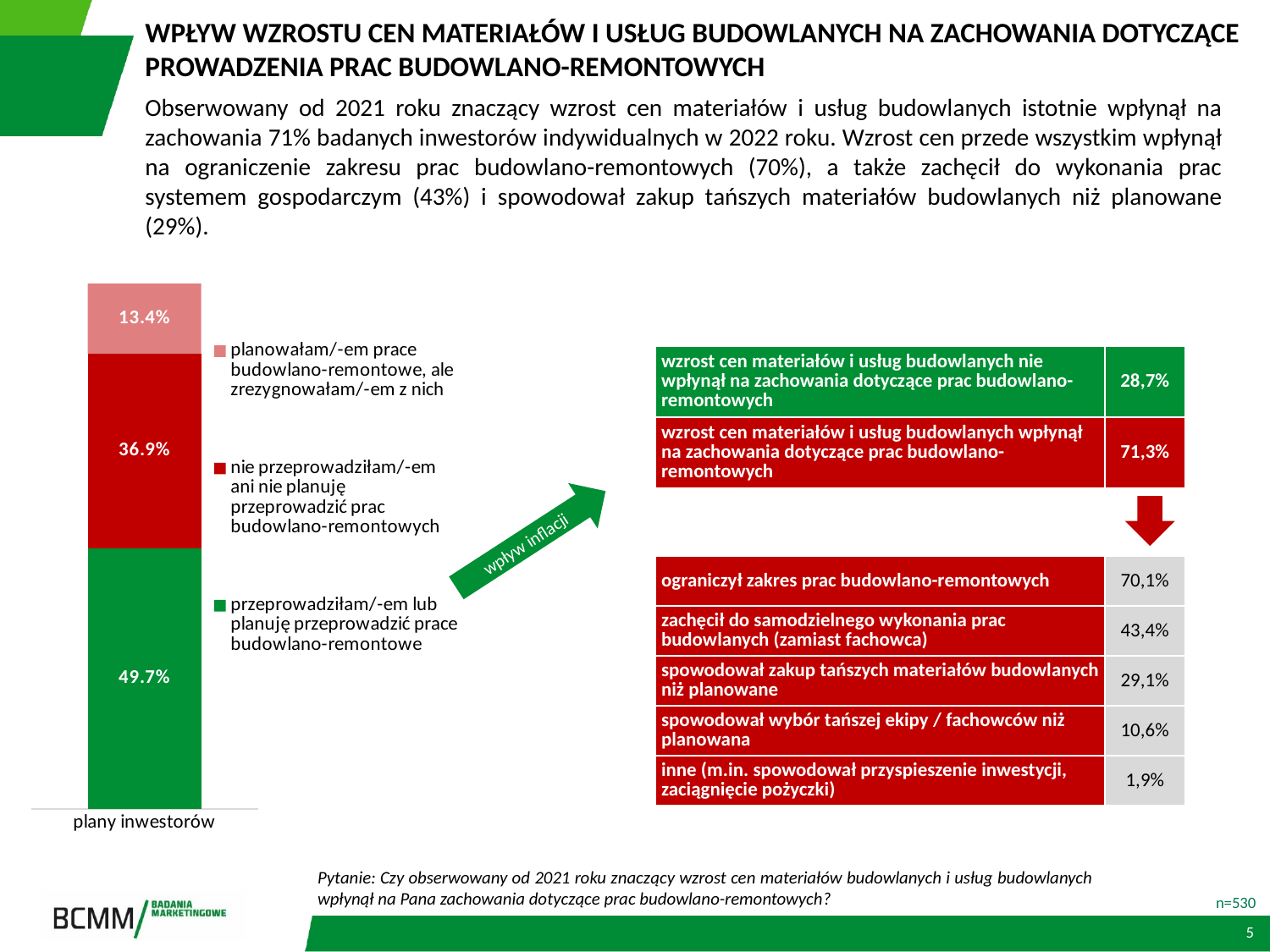
Which segment of the stacked bar chart has the largest value? przeprowadziłam/-em lub planuję przeprowadzić prace budowlano-remontowe What colour is the segment for "przeprowadziłam/-em lub planuję przeprowadzić prace budowlano-remontowe" in the stacked bar chart? green How many series does the legend of the stacked bar chart list? 3 In the stacked bar chart, what is the value for "przeprowadziłam/-em lub planuję przeprowadzić prace budowlano-remontowe"? 49.7% In the stacked bar chart, which is larger: the value for "nie przeprowadziłam/-em ani nie planuję przeprowadzić prac budowlano-remontowych" or the value for "planowałam/-em prace budowlano-remontowe, ale zrezygnowałam/-em z nich"? nie przeprowadziłam/-em ani nie planuję przeprowadzić prac budowlano-remontowych What kind of chart is shown on the left of the slide? stacked bar chart In the stacked bar chart, what is the value for "planowałam/-em prace budowlano-remontowe, ale zrezygnowałam/-em z nich"? 13.4% In the stacked bar chart, what is the difference between the value for "przeprowadziłam/-em lub planuję przeprowadzić prace budowlano-remontowe" and the value for "nie przeprowadziłam/-em ani nie planuję przeprowadzić prac budowlano-remontowych"? 12.8% What is the category label shown under the stacked bar? plany inwestorów Which segment of the stacked bar chart has the smallest value? planowałam/-em prace budowlano-remontowe, ale zrezygnowałam/-em z nich What is the total of the stacked bar in the chart? 100% In the stacked bar chart, what is the value for "nie przeprowadziłam/-em ani nie planuję przeprowadzić prac budowlano-remontowych"? 36.9%